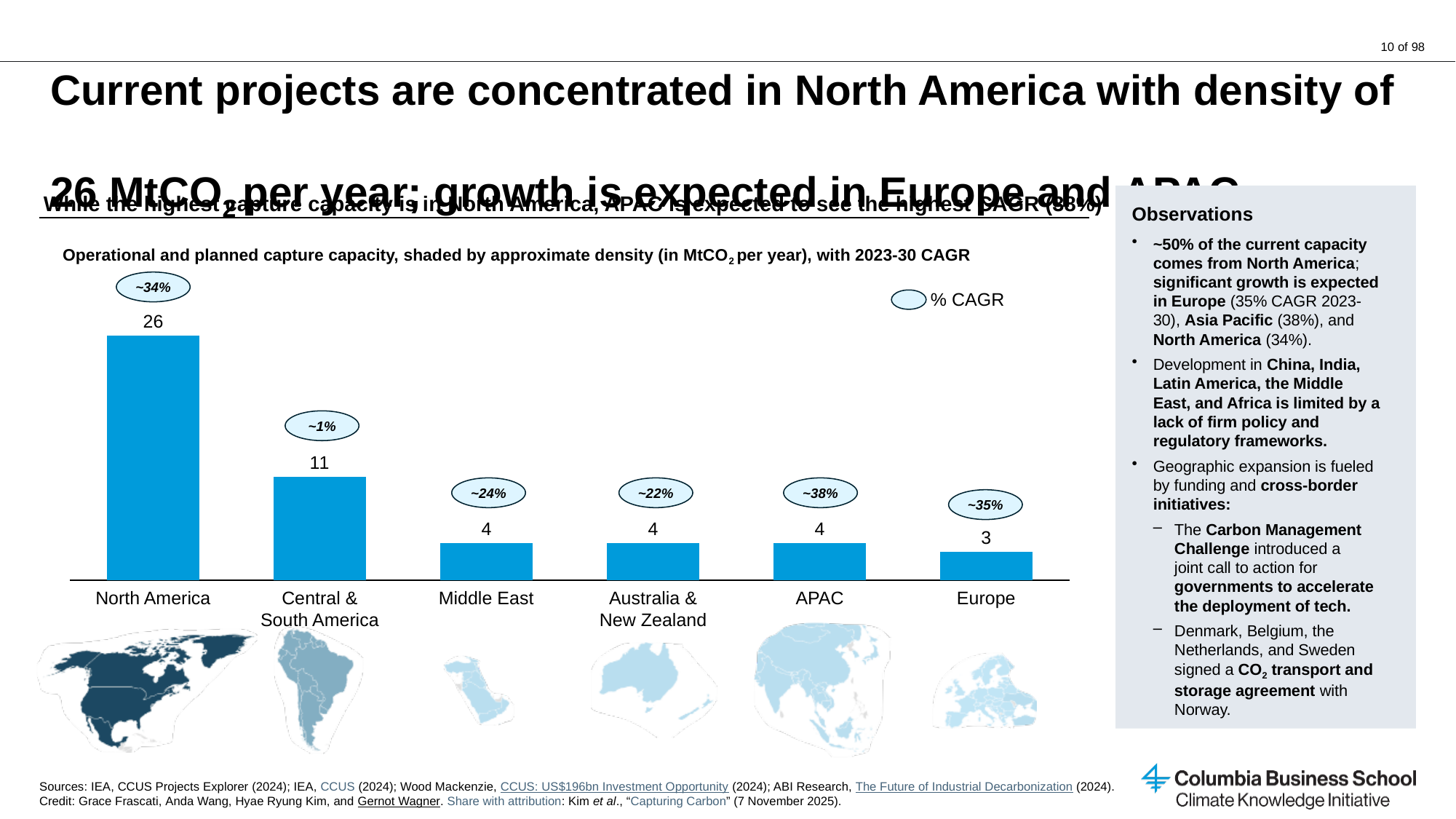
What is the capture capacity value shown for Central & South America? 11 Which region has the lowest capture capacity in the chart? Europe What 2023-30 CAGR is shown in the bubble above the Central & South America bar? ~1% How many regions are shown as bars in the chart? 6 Which has a larger capture capacity, Central & South America or Middle East? Central & South America What is the capture capacity value shown for North America? 26 What is the capture capacity value shown for Europe? 3 What is the difference in capture capacity between North America and Central & South America? 15 What 2023-30 CAGR is shown in the bubble above the APAC bar? ~38% What does the oval symbol in the chart legend represent? % CAGR What type of chart is used to show capture capacity by region? Bar chart Which region has the highest capture capacity in the chart? North America